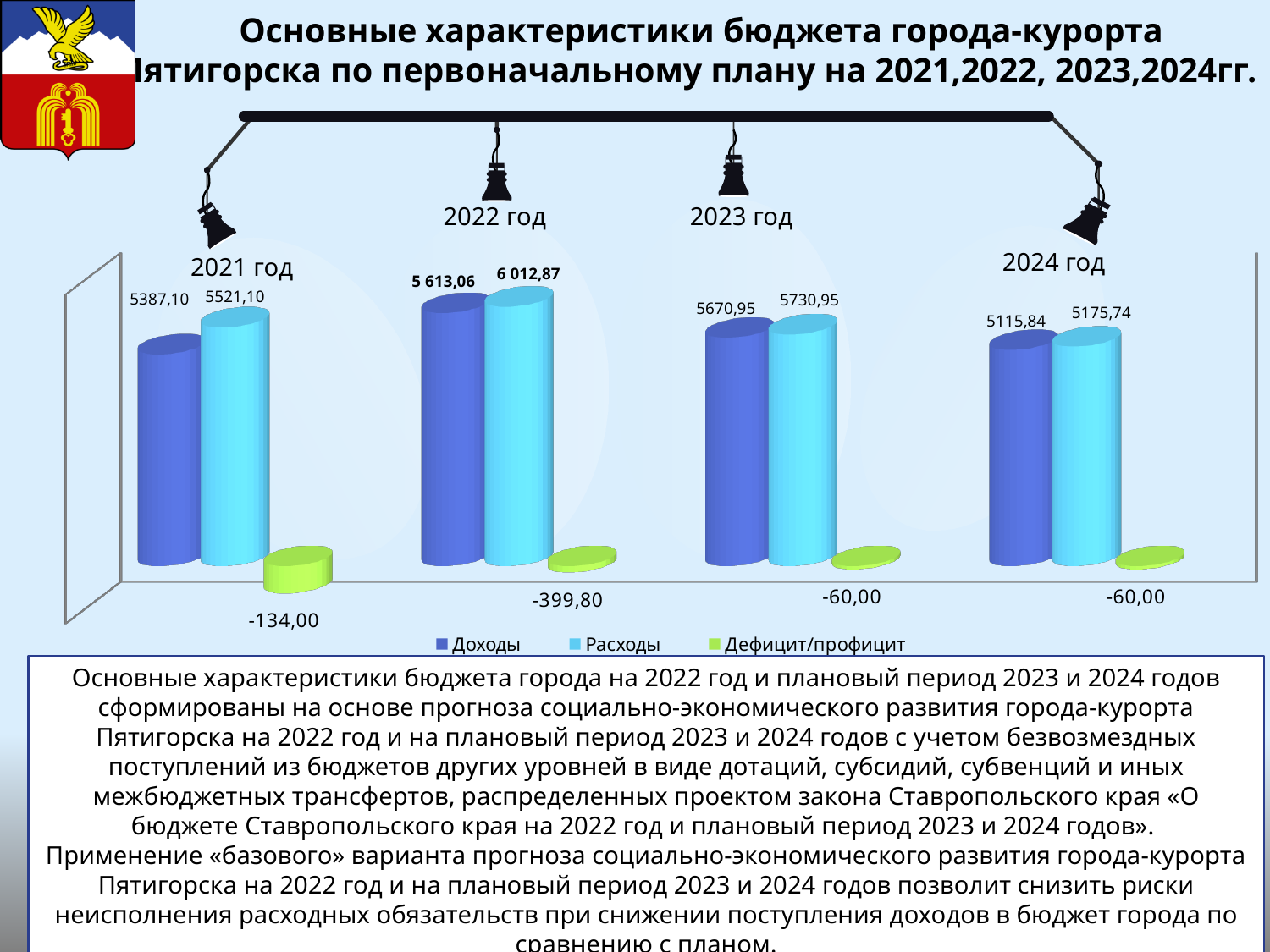
What is the value of Дефицит/профицит for 2023 год? -60,00 What is the value of Доходы for 2021 год? 5387,10 What is the value of Доходы for 2024 год? 5115,84 How many series does the legend list? 3 In which year is Расходы the highest? 2022 год What is the difference between Расходы and Доходы for 2021 год? 134,00 What is the difference between Расходы and Доходы for 2023 год? 60,00 How many years are shown on the chart? 4 In which year is Доходы the lowest? 2024 год What kind of chart is shown on the slide? Bar chart Which is larger for 2022 год: Доходы or Расходы? Расходы What is the value of Расходы for 2022 год? 6 012,87